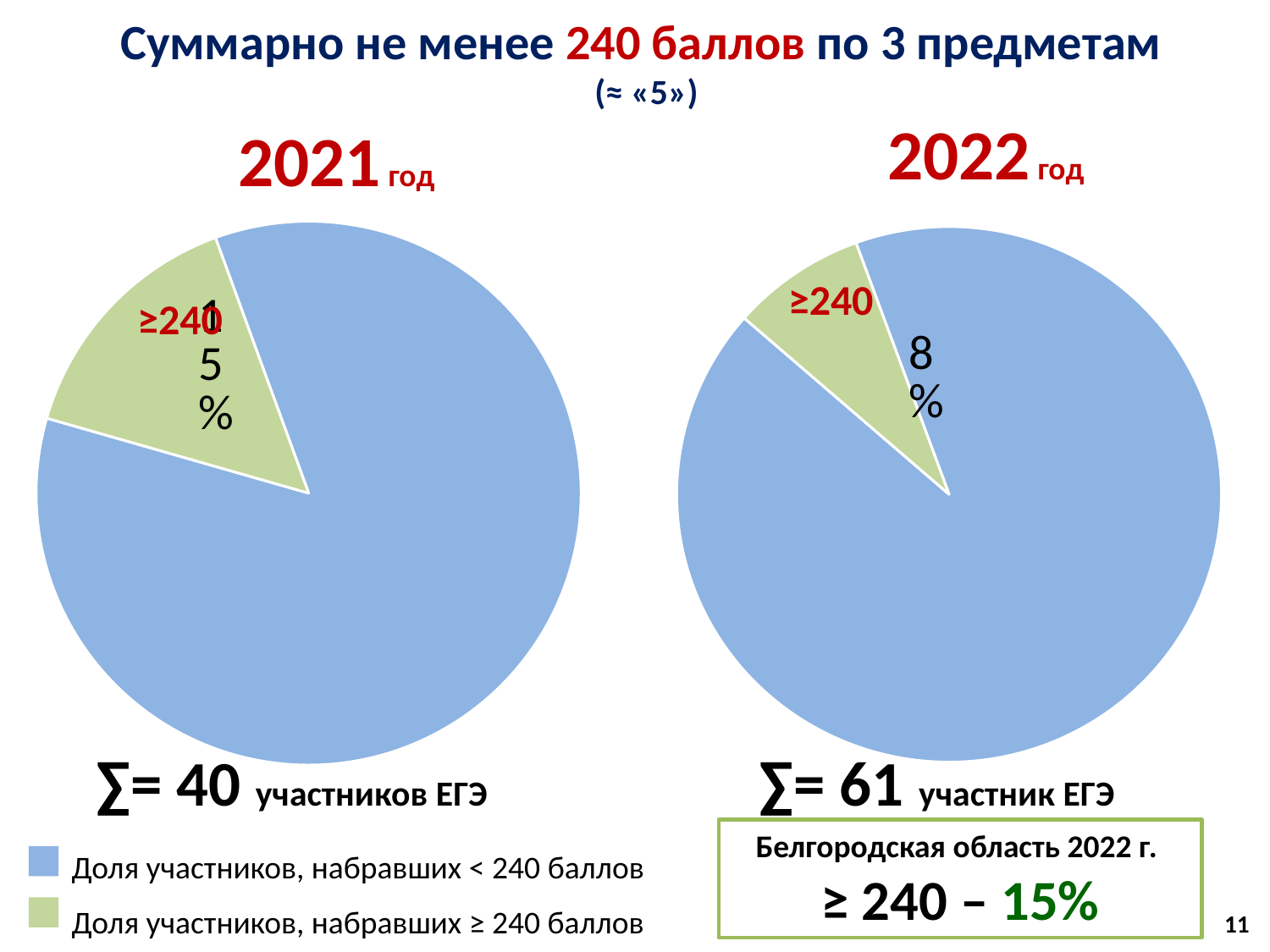
How many slices does each pie chart have? 2 What colour represents the share of participants who scored ≥ 240 points? Green In the 2022 pie chart, what share of participants scored ≥ 240 points? 8% How many ЕГЭ participants are represented in the 2021 pie chart? 40 Which year has the larger share of participants scoring ≥ 240 points, 2021 or 2022? 2021 In the 2021 pie chart, what share of participants scored ≥ 240 points? 15% What kind of charts are shown on the slide? Pie charts In the 2022 pie chart, which slice is larger: participants with < 240 points or participants with ≥ 240 points? < 240 points By how many percentage points does the ≥ 240 share in 2021 exceed that in 2022? 7 What is the title of the slide above the pie charts? Суммарно не менее 240 баллов по 3 предметам How many ЕГЭ participants are represented in the 2022 pie chart? 61 How many entries does the legend list? 2